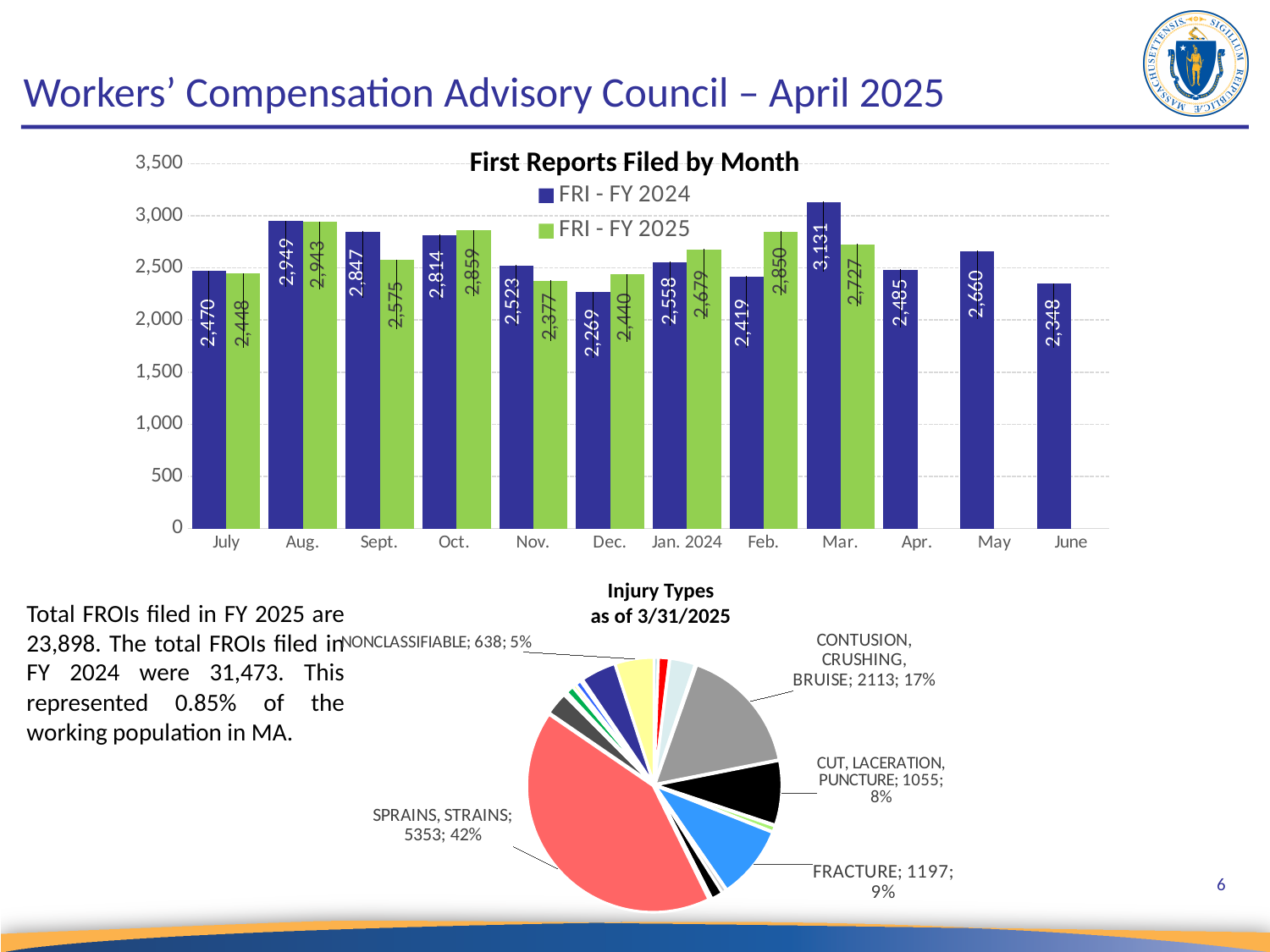
In the 'Injury Types as of 3/31/2025' pie chart, what share does SPRAINS, STRAINS represent? 42% In the 'Injury Types as of 3/31/2025' pie chart, what is the count for FRACTURE? 1197 How many series does the legend of the 'First Reports Filed by Month' chart list? 2 In the 'First Reports Filed by Month' chart, which series has the larger value for Dec., FRI - FY 2024 or FRI - FY 2025? FRI - FY 2025 In the 'First Reports Filed by Month' chart, which month has the lowest FRI - FY 2024 value? Dec. In the 'First Reports Filed by Month' chart, what is the FRI - FY 2025 value for Feb.? 2,850 In the 'First Reports Filed by Month' chart, which month has the highest FRI - FY 2024 value? Mar. In the 'Injury Types as of 3/31/2025' pie chart, which labelled injury type has the largest slice? SPRAINS, STRAINS What kind of chart is 'First Reports Filed by Month'? Bar chart In the 'First Reports Filed by Month' chart, what is the difference between the FY 2024 and FY 2025 values for Sept.? 272 In the 'First Reports Filed by Month' chart, what is the FRI - FY 2024 value for Mar.? 3,131 In the 'First Reports Filed by Month' chart, how many months have an FRI - FY 2025 bar? 9